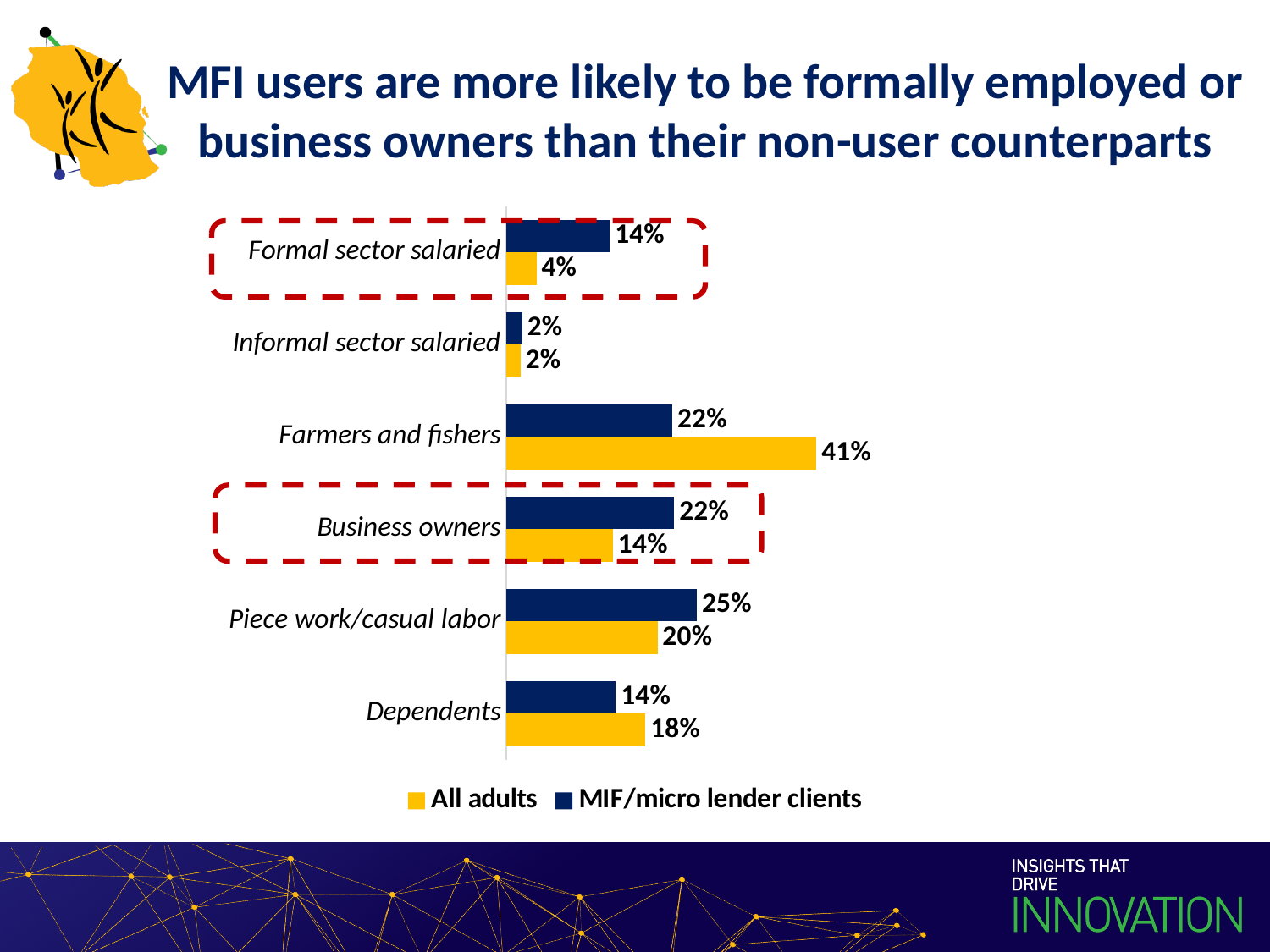
Which colour represents all adults in the chart? Yellow Which category has the highest value for all adults? Farmers and fishers For dependents, which series has the larger value: all adults or MIF/micro lender clients? All adults What kind of chart is shown on the slide? Bar chart How many series does the legend list? 2 What percentage of MIF/micro lender clients are formal sector salaried? 14% What percentage of all adults are farmers and fishers? 41% Which category has the lowest value for MIF/micro lender clients? Informal sector salaried How many categories are shown on the chart? 6 What percentage of all adults are business owners? 14% What is the difference between all adults and MIF/micro lender clients for farmers and fishers? 19% What percentage of MIF/micro lender clients are in piece work/casual labor? 25%